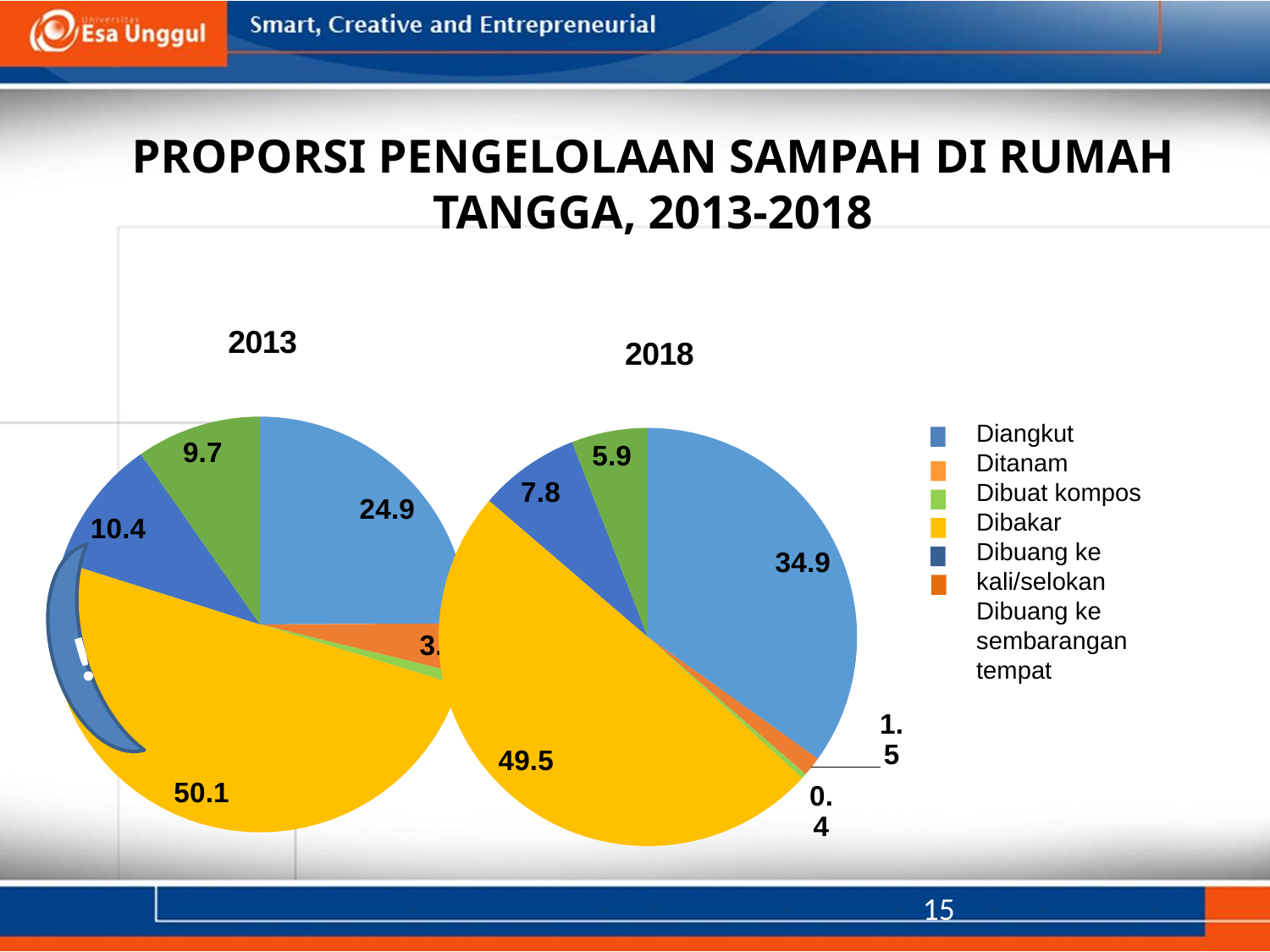
What kind of charts are shown on the slide? Pie charts In the 2018 pie chart, what is the difference between the Dibakar value and the Diangkut value? 14.6 What is the difference between the Diangkut value in the 2018 pie chart and the Diangkut value in the 2013 pie chart? 10.0 In the 2018 pie chart, which category has the largest share? Dibakar Is the Dibakar value larger in the 2013 pie chart or the 2018 pie chart? 2013 In the 2018 pie chart, what is the value for Dibakar? 49.5 In the 2013 pie chart, what is the value for Diangkut? 24.9 In the 2013 pie chart, which category has the largest share? Dibakar In the 2018 pie chart, what is the value for Dibuang ke kali/selokan? 7.8 What is the title of the slide's charts? PROPORSI PENGELOLAAN SAMPAH DI RUMAH TANGGA, 2013-2018 How many categories does the legend list? 6